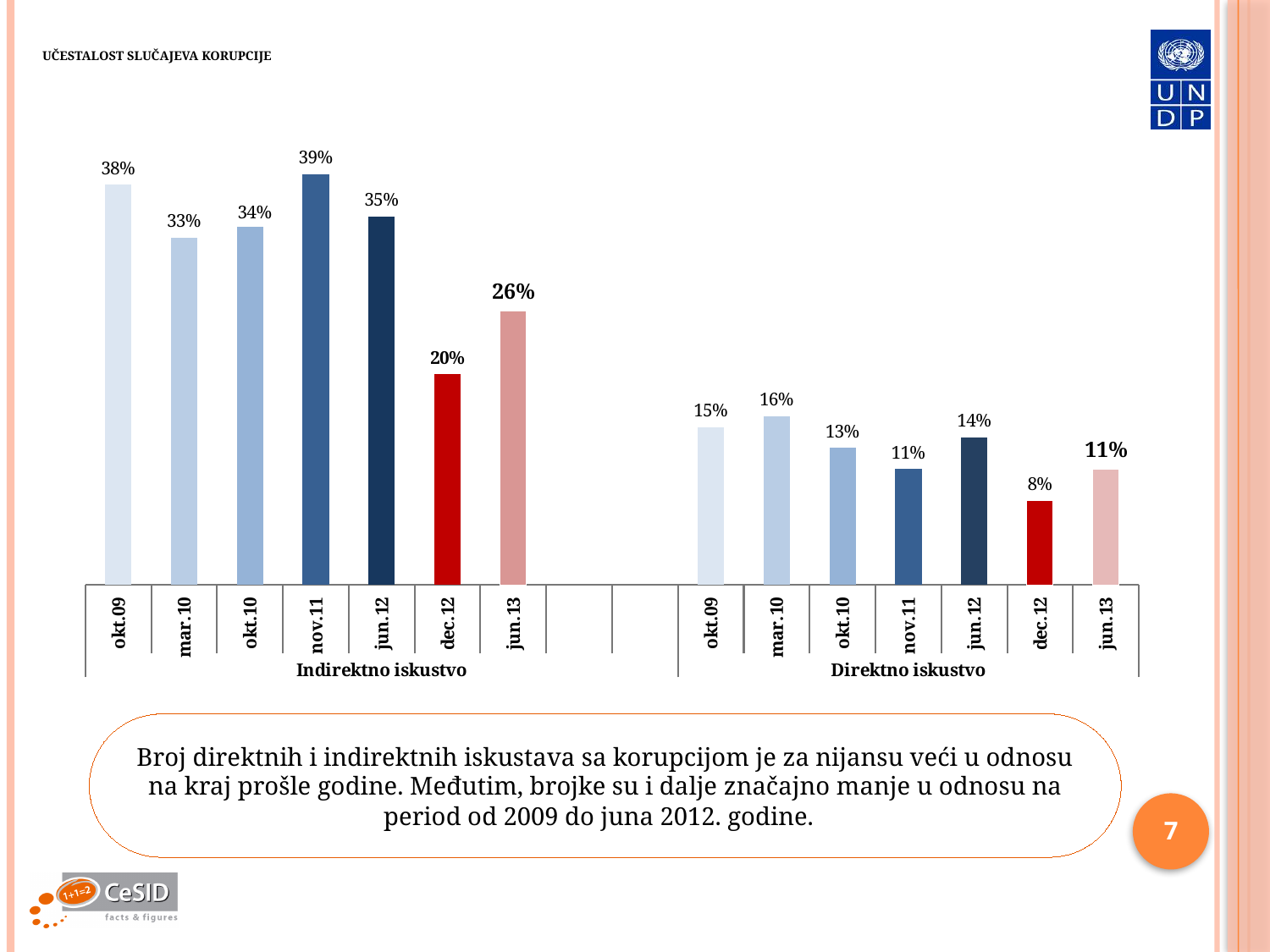
Which period has the highest value in the Indirektno iskustvo group? nov.11 What is the difference between the okt.09 values of the Indirektno iskustvo and Direktno iskustvo groups? 23% What is the value for dec.12 in the Direktno iskustvo group? 8% What is the value for nov.11 in the Indirektno iskustvo group? 39% Which period has the lowest value in the Indirektno iskustvo group? dec.12 What kind of chart is shown on the slide? Bar chart Which is larger in the Direktno iskustvo group: mar.10 or jun.12? mar.10 Which period has the lowest value in the Direktno iskustvo group? dec.12 What are the two group labels shown below the x axis? Indirektno iskustvo and Direktno iskustvo What is the difference between the jun.13 and dec.12 values in the Indirektno iskustvo group? 6% What is the value for jun.13 in the Indirektno iskustvo group? 26% How many bars are shown in the Direktno iskustvo group? 7